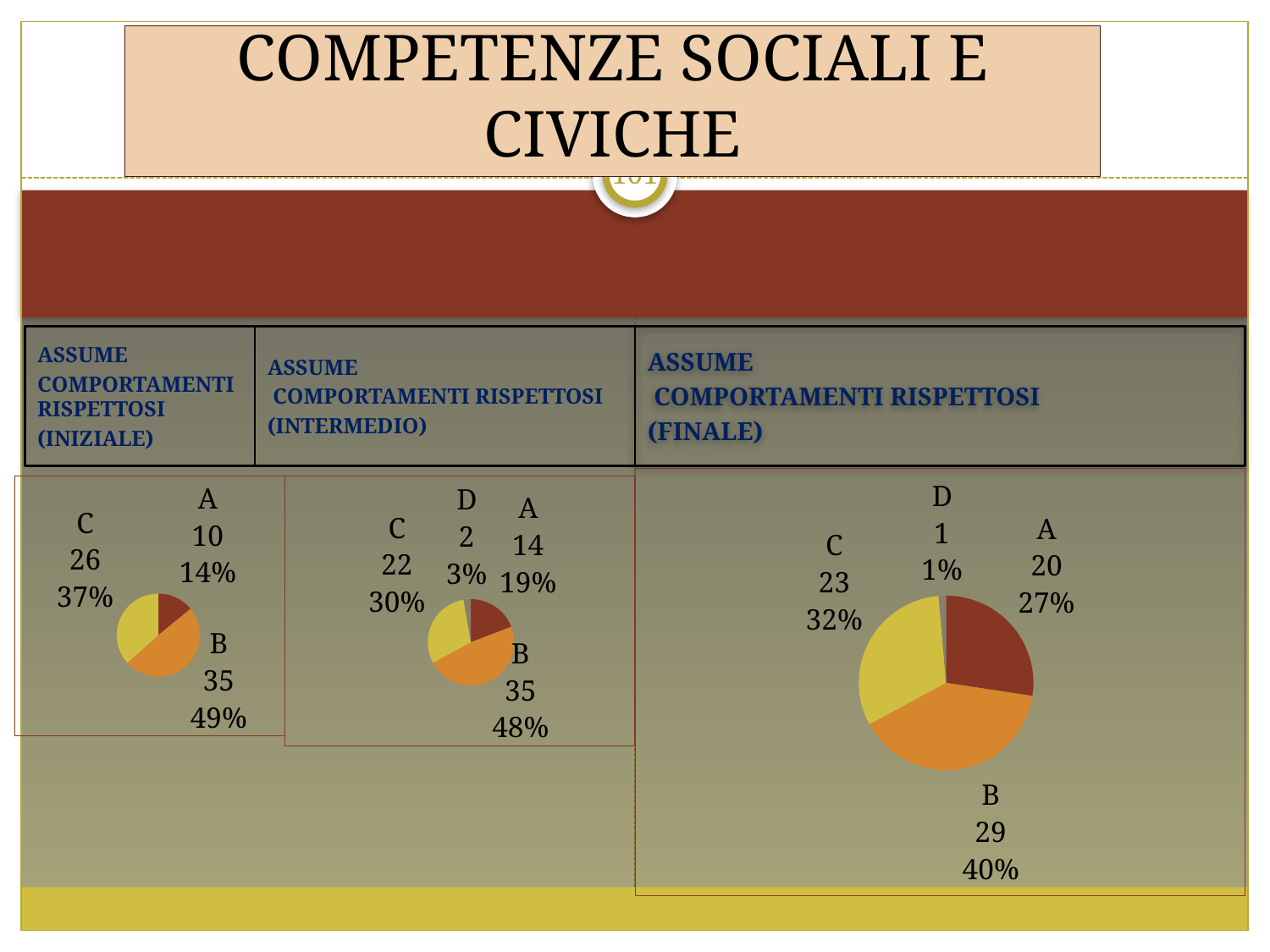
In the INIZIALE pie chart (left), what value is shown for category B? 35 In the INTERMEDIO pie chart (middle), what value is shown for category D? 2 In the INTERMEDIO pie chart (middle), which category has the largest share? B In the FINALE pie chart (right), what percentage share does category A have? 27% In the FINALE pie chart (right), what is the difference between the values for B and A? 9 In the FINALE pie chart (right), which is larger, the value for B or the value for C? B In the INIZIALE pie chart (left), which category has the smallest value? A In the FINALE pie chart (right), which category has the smallest value? D What type of chart is used in the FINALE section (right)? Pie chart In the INTERMEDIO pie chart (middle), how many categories are shown? 4 In the INIZIALE pie chart (left), what percentage share does category C have? 37% In the INTERMEDIO pie chart (middle), what is the difference between the values for C and A? 8